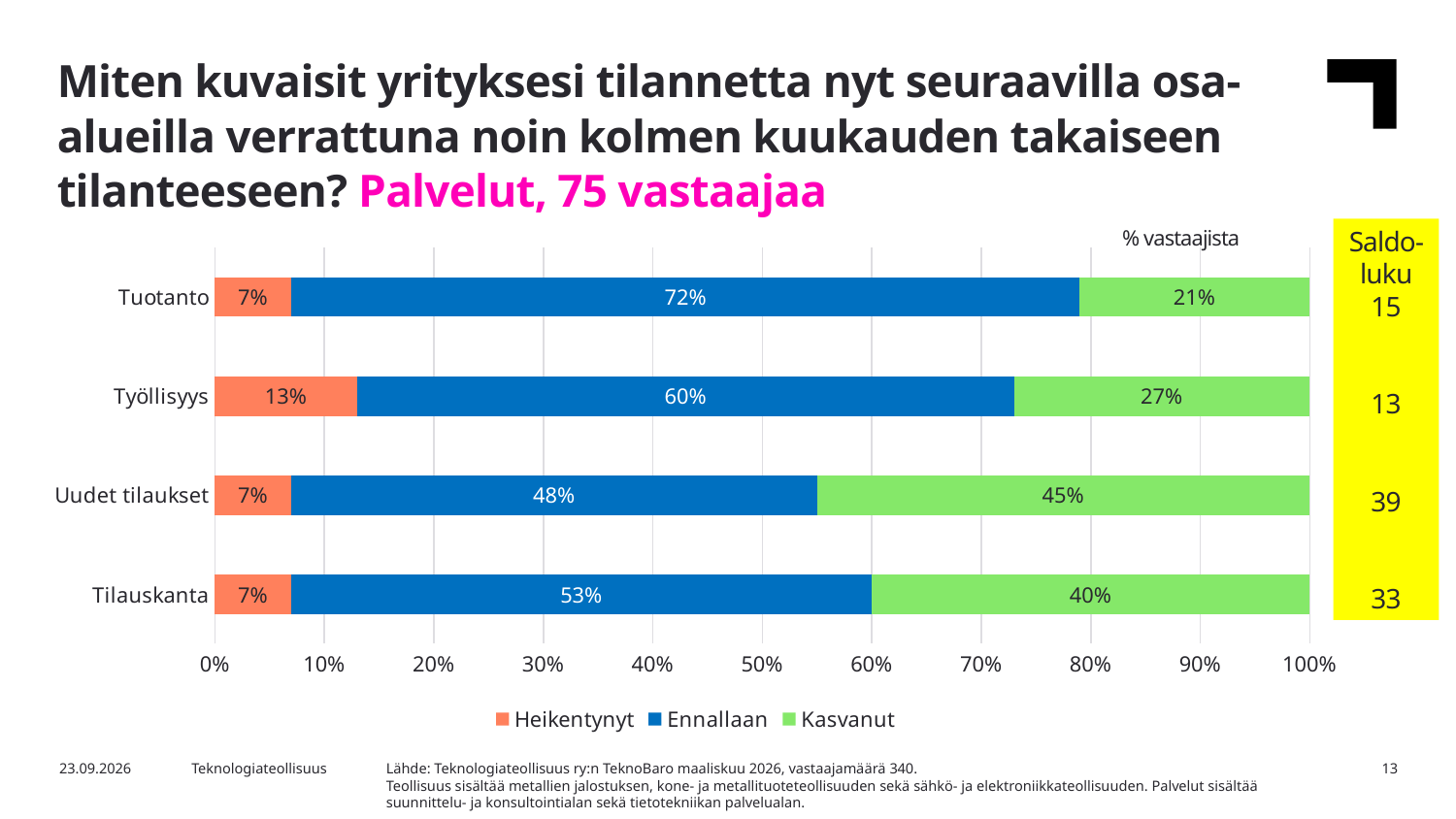
What is the total of the three segments in the Työllisyys bar? 100% What is the "Heikentynyt" value for Työllisyys? 13% What is the "Kasvanut" value for Uudet tilaukset? 45% What percentage of respondents answered "Ennallaan" for Tuotanto? 72% Which category has the highest "Kasvanut" share? Uudet tilaukset What is the difference between the "Kasvanut" values for Tilauskanta and Tuotanto? 19 percentage points Which category has the lowest "Ennallaan" share? Uudet tilaukset How many categories are shown on the y axis of the chart? 4 How many series does the legend list? 3 What is the Saldoluku value shown for Uudet tilaukset? 39 Which is larger: the "Ennallaan" value for Työllisyys or for Tilauskanta? Työllisyys What kind of chart is shown on the slide? Stacked bar chart